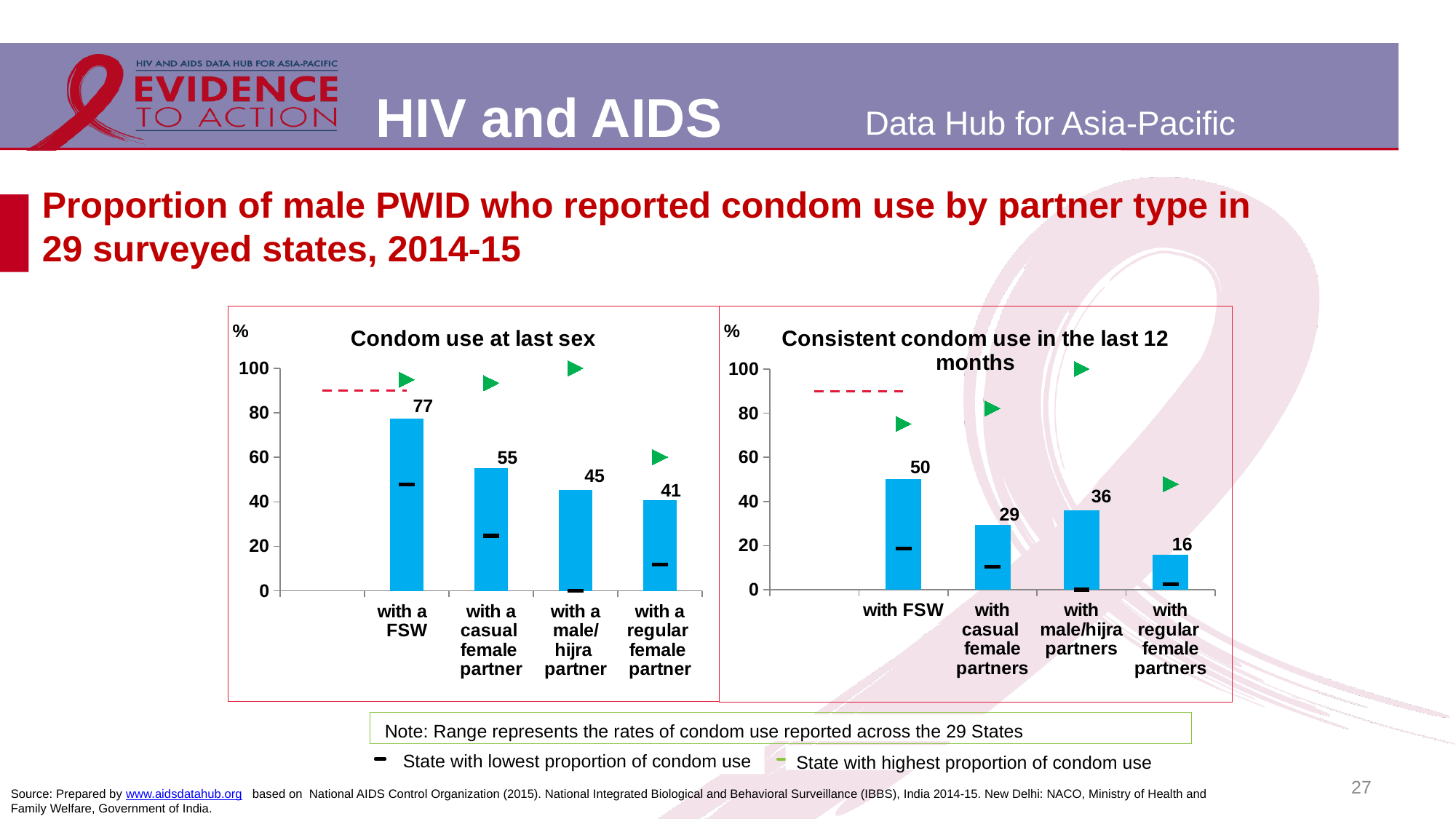
In the 'Consistent condom use in the last 12 months' chart, what is the value for 'with casual female partners'? 29 In the 'Condom use at last sex' chart, which partner type has the highest value? with a FSW In the 'Condom use at last sex' chart, what is the difference between the values for 'with a FSW' and 'with a casual female partner'? 22 In the 'Consistent condom use in the last 12 months' chart, do the bar values rise or fall from 'with FSW' to 'with casual female partners'? Fall In the 'Consistent condom use in the last 12 months' chart, which partner type has the lowest value? with regular female partners In the 'Condom use at last sex' chart, what is the value for 'with a FSW'? 77 In the 'Consistent condom use in the last 12 months' chart, what is the difference between the values for 'with FSW' and 'with male/hijra partners'? 14 How many partner-type categories are shown in the 'Condom use at last sex' chart? 4 What type of chart is the 'Consistent condom use in the last 12 months' chart? Bar chart In the 'Consistent condom use in the last 12 months' chart, what is the value for 'with regular female partners'? 16 Which is larger: the value for 'with a male/hijra partner' in the 'Condom use at last sex' chart or the value for 'with male/hijra partners' in the 'Consistent condom use in the last 12 months' chart? Condom use at last sex (45) In the 'Condom use at last sex' chart, what is the value for 'with a regular female partner'? 41